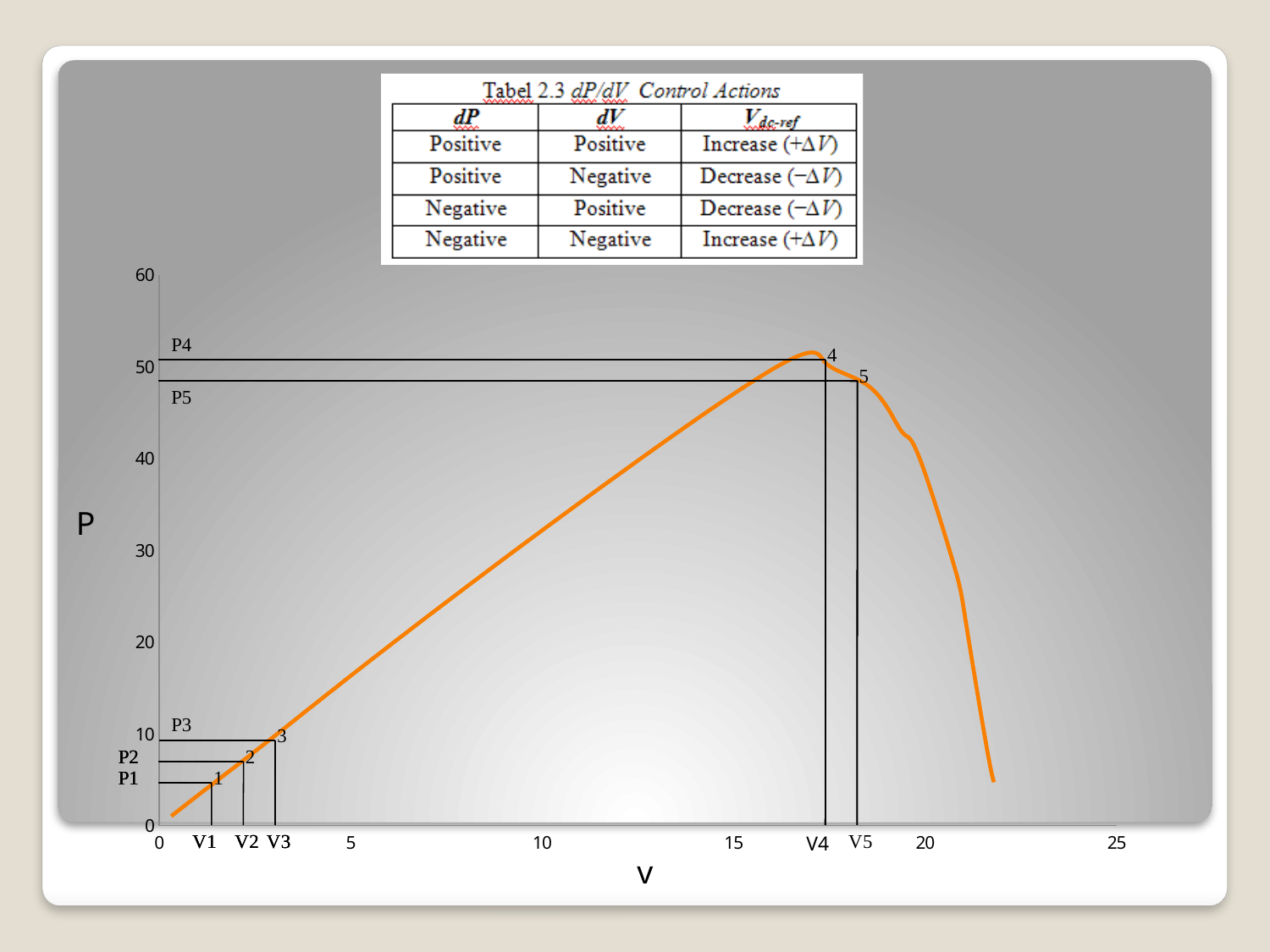
How does P change as V increases along the curve? rises to a peak, then falls What is the label of the horizontal axis of the chart? V Which is larger, V4 or V5? V5 Which numbered point on the curve has the lowest P value? 1 Which is larger, P4 or P5? P4 How many numbered points are marked on the curve? 5 Which numbered point on the curve has the highest P value? 4 Is the value of P1 greater or less than 10? less Is the value of V4 greater or less than 15? greater What is the label of the vertical axis of the chart? P What kind of chart is shown on the slide? line chart Is the value of P5 greater or less than 50? less